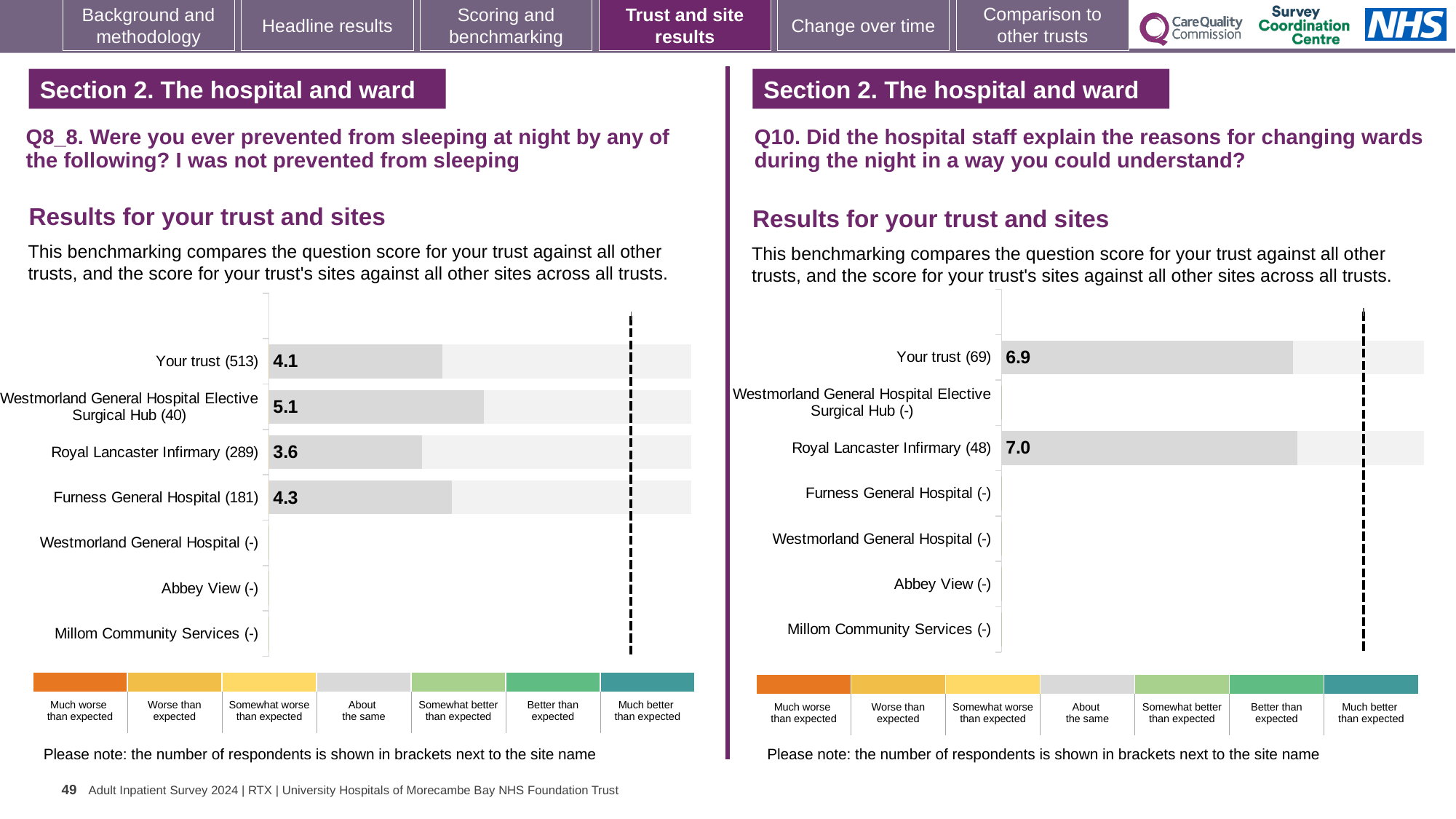
On the Q10 chart (right), what is the score for Your trust? 6.9 On the Q8_8 chart (left), what is the score for Your trust? 4.1 On the Q8_8 chart (left), what is the score for Westmorland General Hospital Elective Surgical Hub? 5.1 On the Q8_8 chart (left), what is the score for Furness General Hospital? 4.3 On the Q10 chart (right), what is the score for Royal Lancaster Infirmary? 7.0 On the Q8_8 chart (left), what is the difference between the scores for Westmorland General Hospital Elective Surgical Hub and Royal Lancaster Infirmary? 1.5 What kind of chart is used on the Q8_8 chart (left)? Bar chart On the Q8_8 chart (left), what is the score for Royal Lancaster Infirmary? 3.6 On the Q8_8 chart (left), which site has the lowest score among those with a plotted value? Royal Lancaster Infirmary How many site categories are listed on the Q10 chart (right)? 7 On the Q8_8 chart (left), which site has the highest score? Westmorland General Hospital Elective Surgical Hub On the Q10 chart (right), how many respondents are shown for Your trust? 69